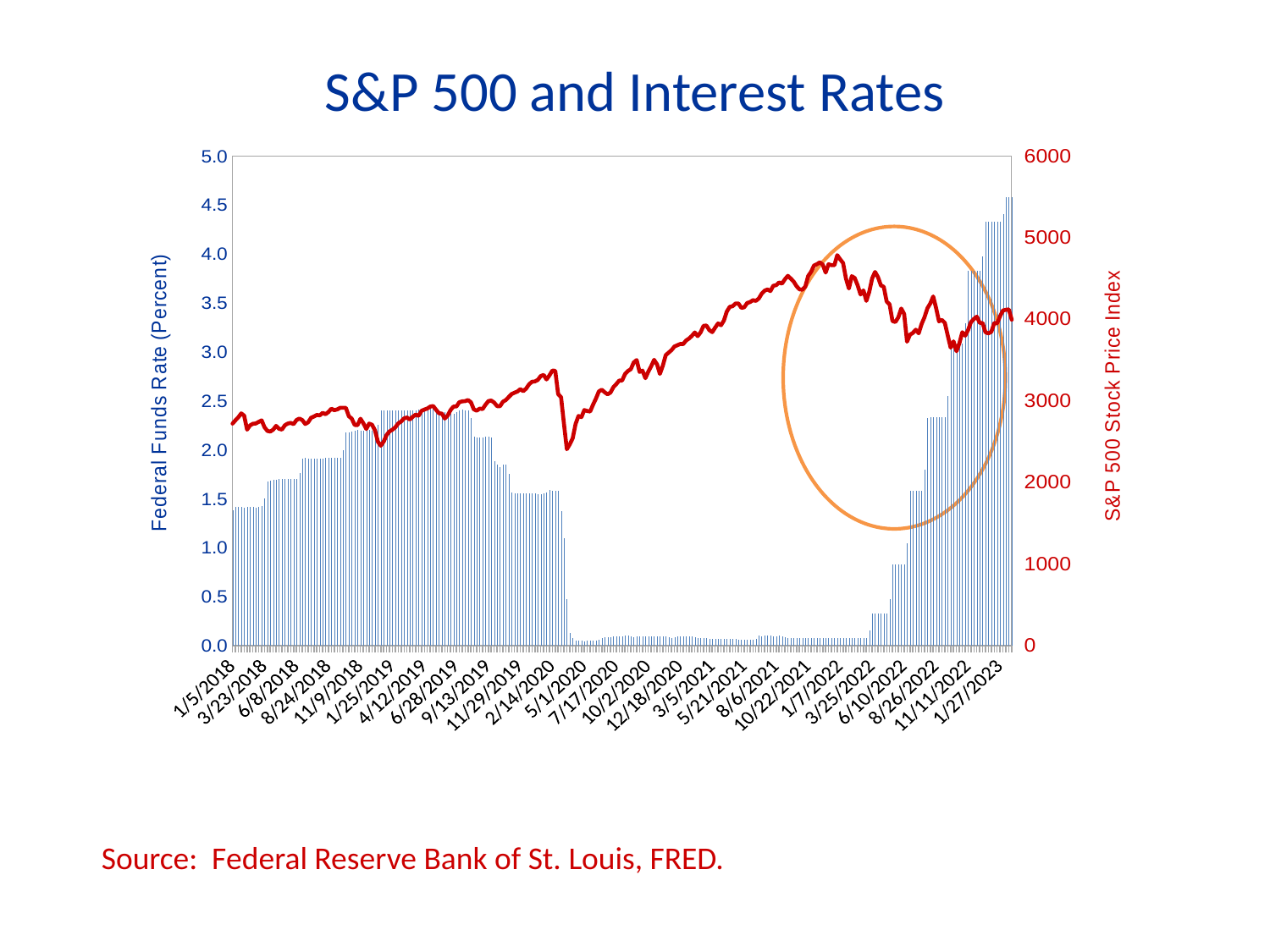
Which is larger, the Federal Funds Rate at 1/25/2019 or at 7/17/2020? 1/25/2019 Does the Federal Funds Rate rise or fall between 3/25/2022 and 1/27/2023? rise Does the S&P 500 Stock Price Index rise or fall between 5/1/2020 and 1/7/2022? rise Is the S&P 500 Stock Price Index at 1/5/2018 greater or less than 3000? less What is the title of the chart? S&P 500 and Interest Rates Is the Federal Funds Rate at 1/27/2023 greater or less than 4.0 percent? greater What kind of chart is shown on the slide? A combination bar and line chart Is the S&P 500 Stock Price Index at 1/7/2022 greater or less than 4000? greater What does the right-hand vertical axis of the chart measure? S&P 500 Stock Price Index